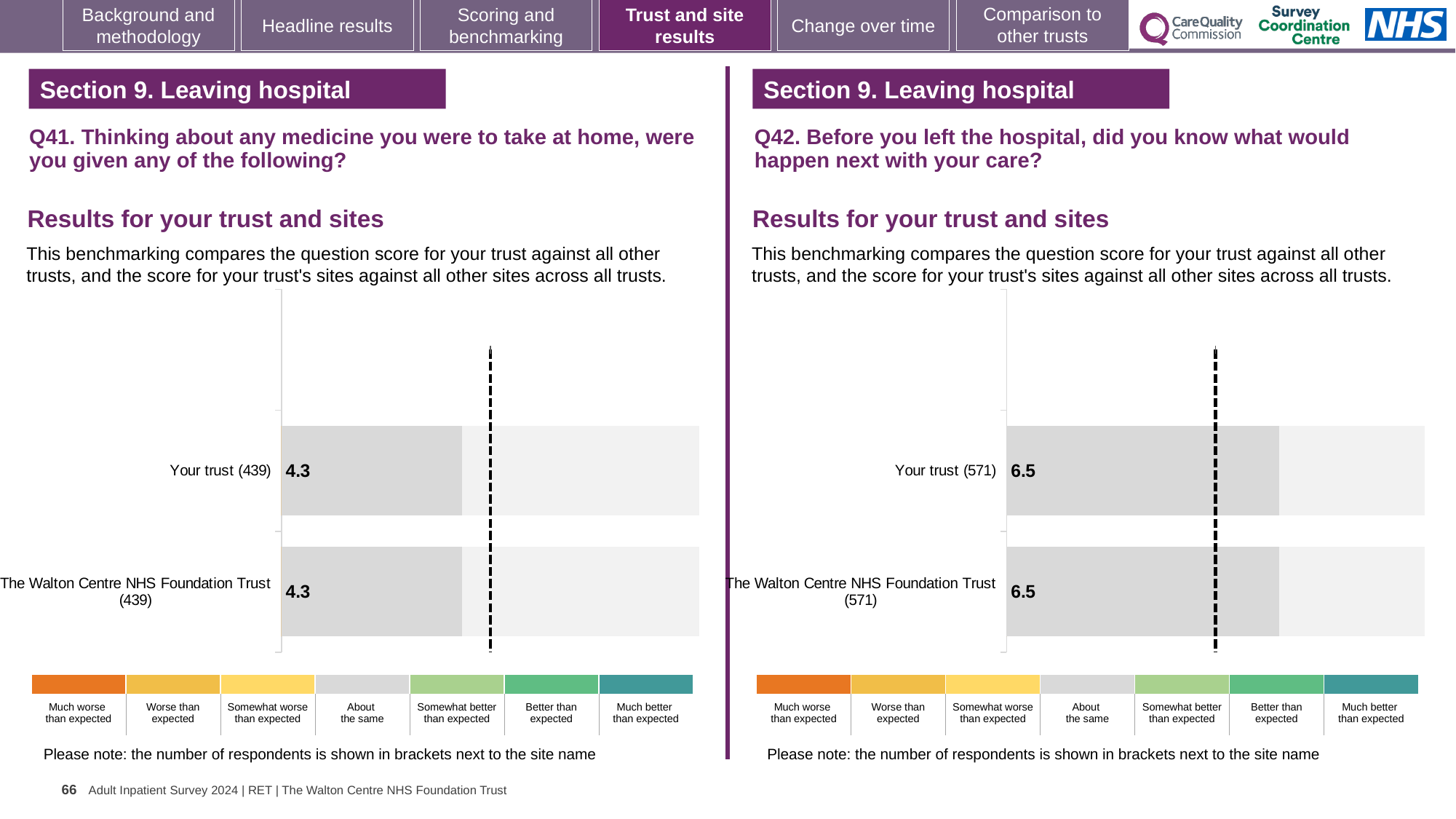
On the Q42 chart (right), what is the score for The Walton Centre NHS Foundation Trust? 6.5 On the Q42 chart (right), what is the score for Your trust? 6.5 What kind of chart is used for the Q42 results (right)? Bar chart On the Q41 chart (left), what is the score for Your trust? 4.3 On the Q42 chart (right), what is the difference between the score for Your trust and the score for The Walton Centre NHS Foundation Trust? 0 How many categories does the colour key below the Q41 chart (left) list? 7 On the Q41 chart (left), what is the difference between the score for Your trust and the score for The Walton Centre NHS Foundation Trust? 0 On the Q42 chart (right), how many respondents are shown in brackets next to The Walton Centre NHS Foundation Trust? 571 How many bars are plotted on the Q41 chart (left)? 2 On the Q41 chart (left), what is the score for The Walton Centre NHS Foundation Trust? 4.3 How many bars are plotted on the Q42 chart (right)? 2 On the Q41 chart (left), how many respondents are shown in brackets next to Your trust? 439